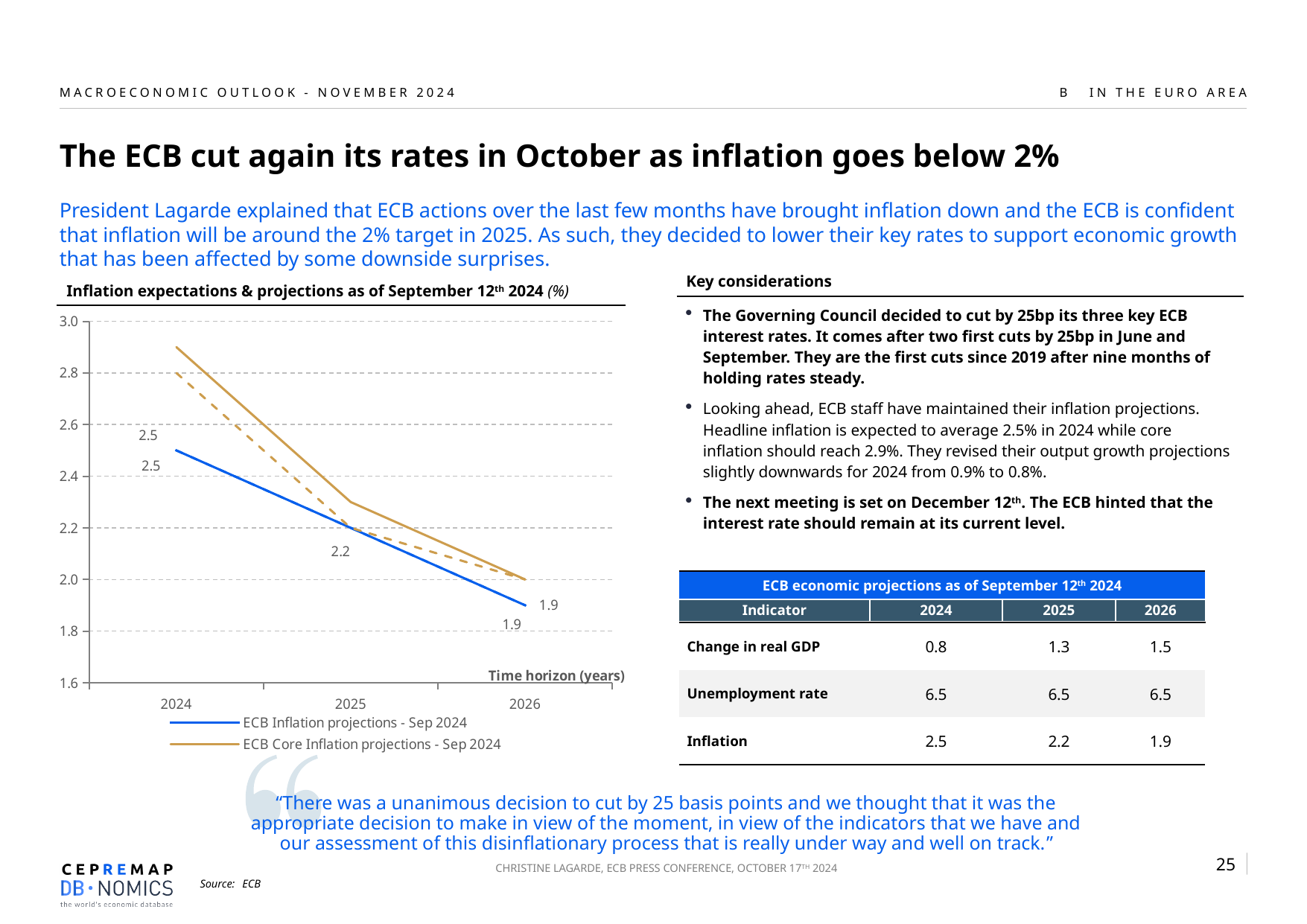
What is the difference between the ECB Inflation projections for 2024 and 2026? 0.6 How many series does the chart legend list? 2 Is the value for ECB Core Inflation projections - Sep 2024 in 2025 greater or less than 2.2? greater What is the value of ECB Inflation projections - Sep 2024 for 2025? 2.2 Is the value for ECB Core Inflation projections - Sep 2024 in 2024 greater or less than 2.8? greater What kind of chart is shown on the slide? line chart Do the ECB Inflation projections rise or fall from 2024 to 2026? fall What is the value of ECB Inflation projections - Sep 2024 for 2026? 1.9 How many years are shown on the x axis of the chart? 3 What is the title of the chart? Inflation expectations & projections as of September 12th 2024 (%) In 2024, which series is higher: ECB Inflation projections or ECB Core Inflation projections? ECB Core Inflation projections - Sep 2024 What is the value of ECB Inflation projections - Sep 2024 for 2024? 2.5